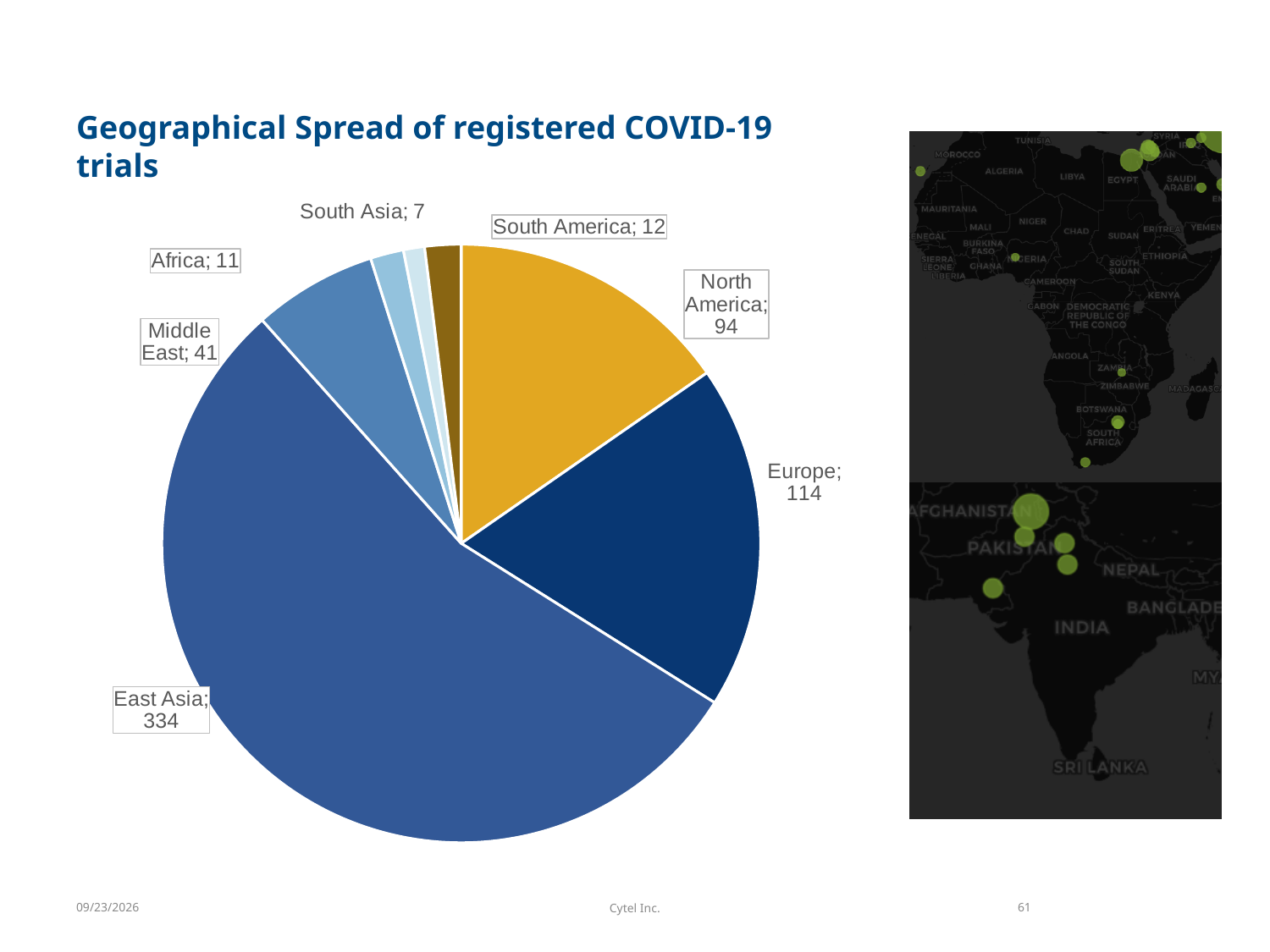
What is the total of all the values shown in the pie chart? 613 Which region has the smallest slice of the pie? South Asia What type of chart is shown on the slide? Pie chart What is the difference between the values for Europe and North America? 20 What is the value for the Middle East? 41 Which is larger, the value for South America or the value for Africa? South America How many regions are shown in the pie chart? 7 What is the value for Europe? 114 How many trials are registered in East Asia? 334 What is the value for South Asia? 7 What is the title of the chart? Geographical Spread of registered COVID-19 trials Which region has the largest slice of the pie? East Asia